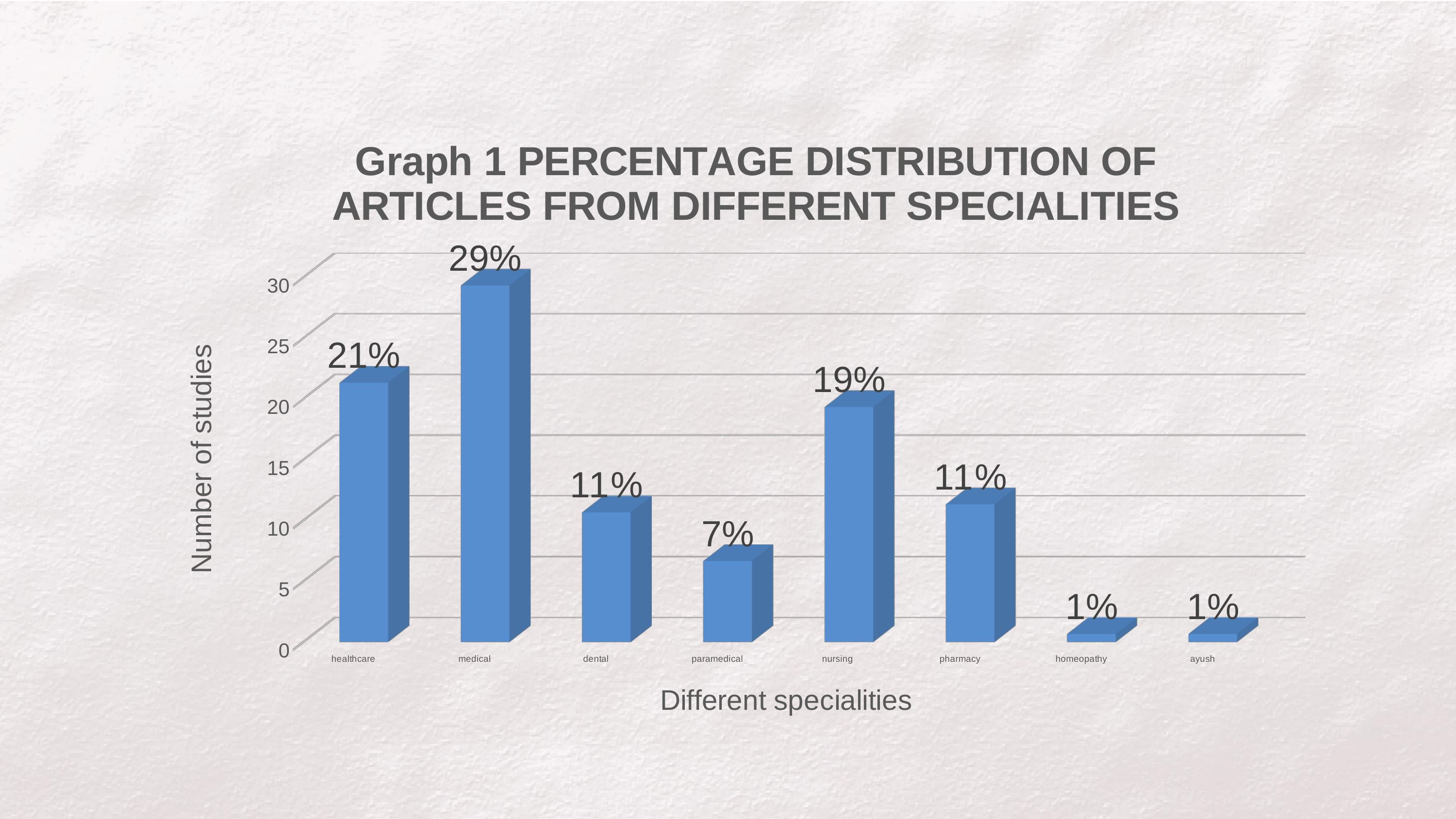
Is the value for dental greater or less than 15? less What kind of chart is shown on the slide? bar chart Which speciality has the highest value? medical How many specialities are shown on the x axis? 8 What is the value for nursing? 19% What is the difference between the values for medical and healthcare? 8% What is the value for paramedical? 7% Which is larger, the value for healthcare or the value for nursing? healthcare What is the difference between the values for nursing and paramedical? 12% What is the value for healthcare? 21% What is the label of the y axis? Number of studies What is the value for medical? 29%